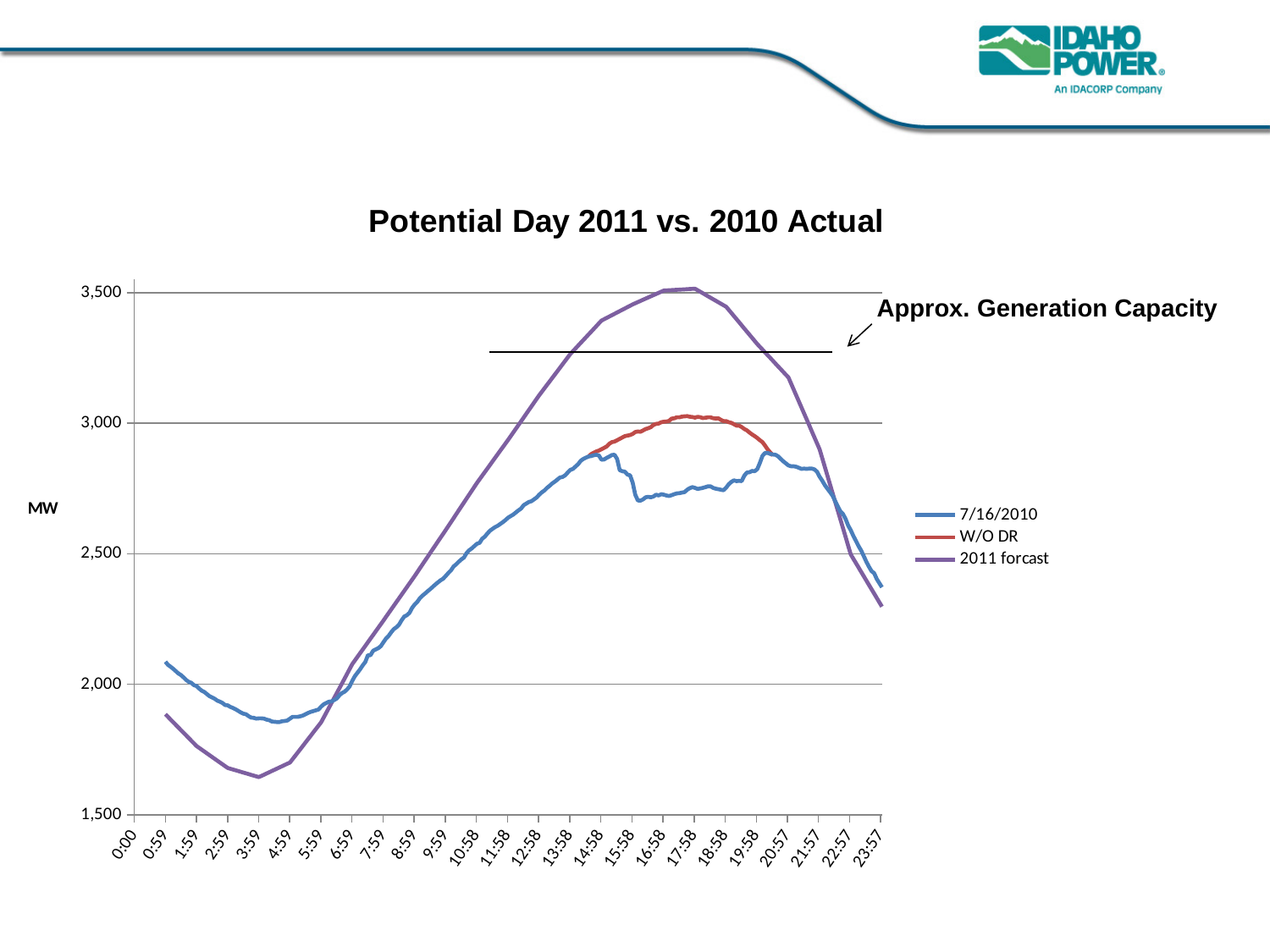
Is the value of the 7/16/2010 series at 3:59 greater or less than 2,000? less What kind of chart is shown on the slide? Line chart Which series reaches the highest value on the chart? 2011 forcast Does the 2011 forcast series rise or fall between 3:59 and 17:58? rise What label is shown on the vertical axis of the chart? MW What is the title of the chart? Potential Day 2011 vs. 2010 Actual At 17:58, which series has the larger value: 7/16/2010 or 2011 forcast? 2011 forcast How many series does the legend list? 3 Is the value of the 2011 forcast series at 3:59 greater or less than 2,000? less Which series reaches the lowest value on the chart? 2011 forcast At 0:59, which series has the larger value: 7/16/2010 or 2011 forcast? 7/16/2010 Is the value of the 2011 forcast series at 17:58 greater or less than 3,000? greater